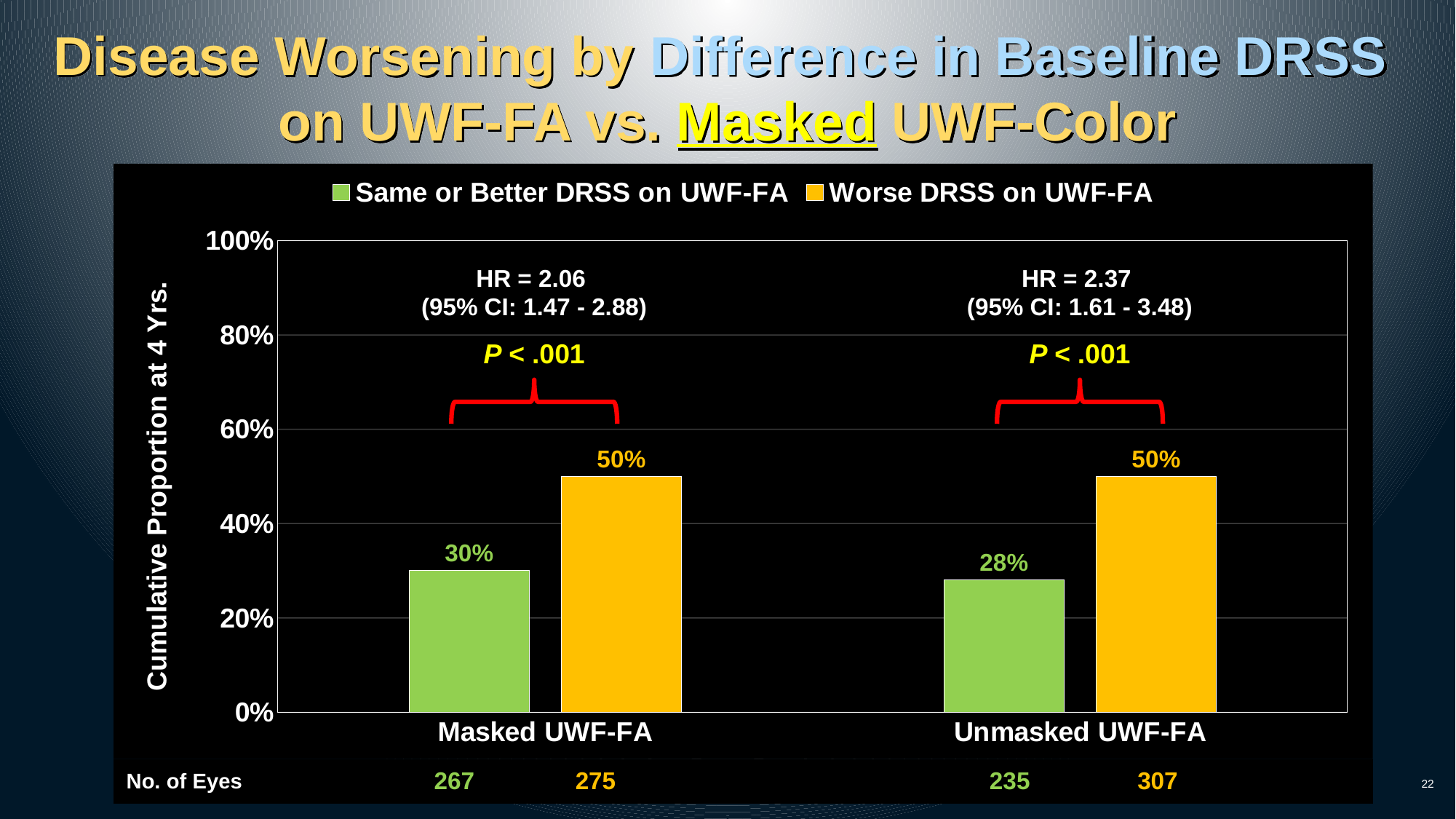
What is the number of eyes for Worse DRSS on UWF-FA in the Unmasked UWF-FA group? 307 Which series has the larger value in the Unmasked UWF-FA group? Worse DRSS on UWF-FA What kind of chart is shown on the slide? Bar chart How many groups are shown on the x axis? 2 What is the hazard ratio shown for the Masked UWF-FA group? 2.06 What is the difference between the Worse DRSS and Same or Better DRSS bars in the Unmasked UWF-FA group? 22% What is the cumulative proportion at 4 years for Same or Better DRSS on UWF-FA in the Masked UWF-FA group? 30% What is the cumulative proportion at 4 years for Worse DRSS on UWF-FA in the Unmasked UWF-FA group? 50% How many series does the legend list? 2 What is the cumulative proportion at 4 years for Same or Better DRSS on UWF-FA in the Unmasked UWF-FA group? 28% Which group has the lower value for Same or Better DRSS on UWF-FA? Unmasked UWF-FA What is the difference between the Worse DRSS and Same or Better DRSS bars in the Masked UWF-FA group? 20%